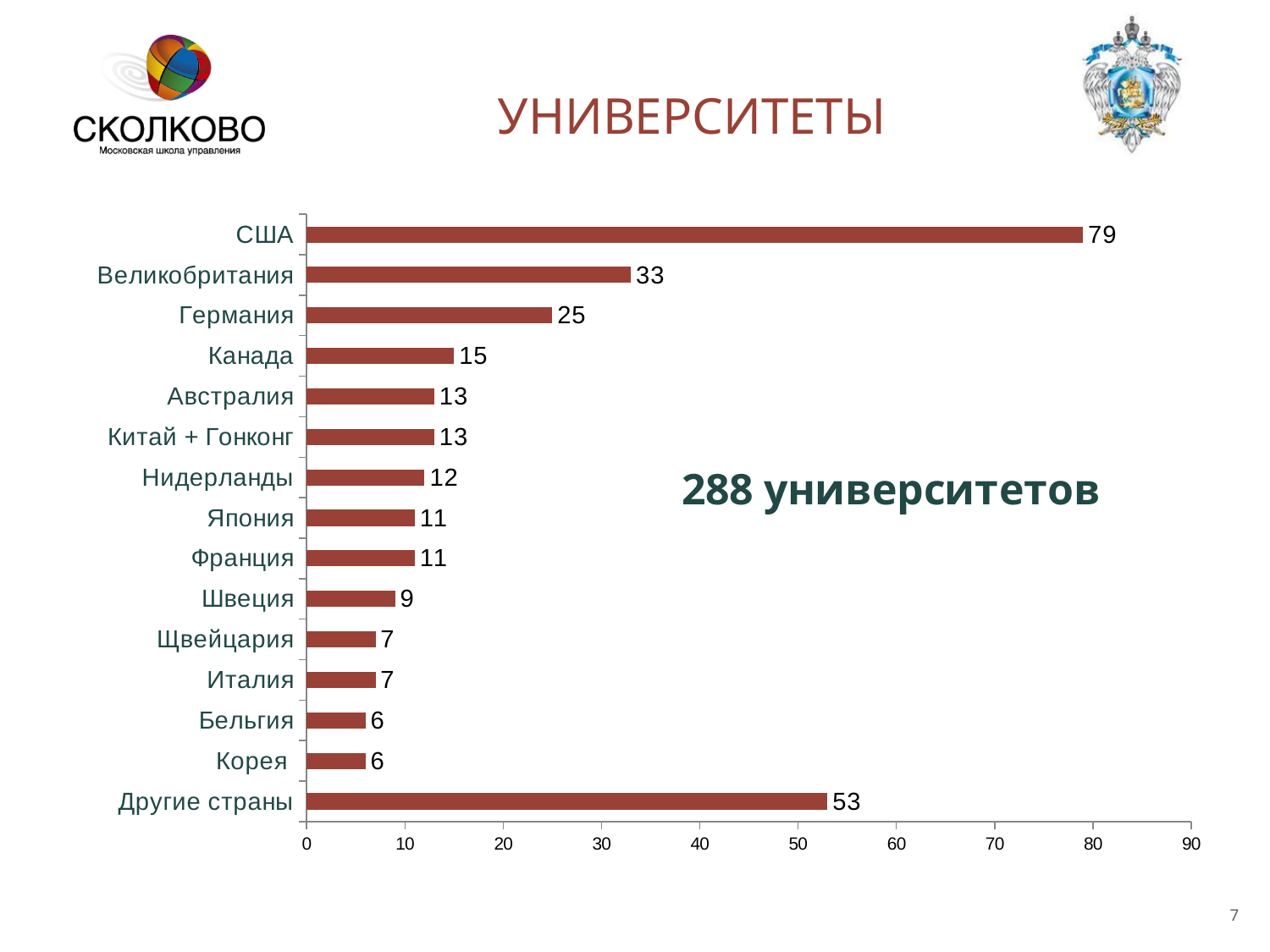
Which category has the highest value? США What total number of universities is stated in the text next to the chart? 288 университетов Which is larger, the value for Канада or the value for Нидерланды? Канада Is the value for Великобритания greater or less than 30? greater What is the value for Другие страны? 53 How many categories are shown on the chart? 15 What is the value for Швеция? 9 What kind of chart is shown on the slide? bar chart What is the value for Германия? 25 What is the difference between the values for Другие страны and Германия? 28 What is the value for США? 79 What is the difference between the values for США and Великобритания? 46